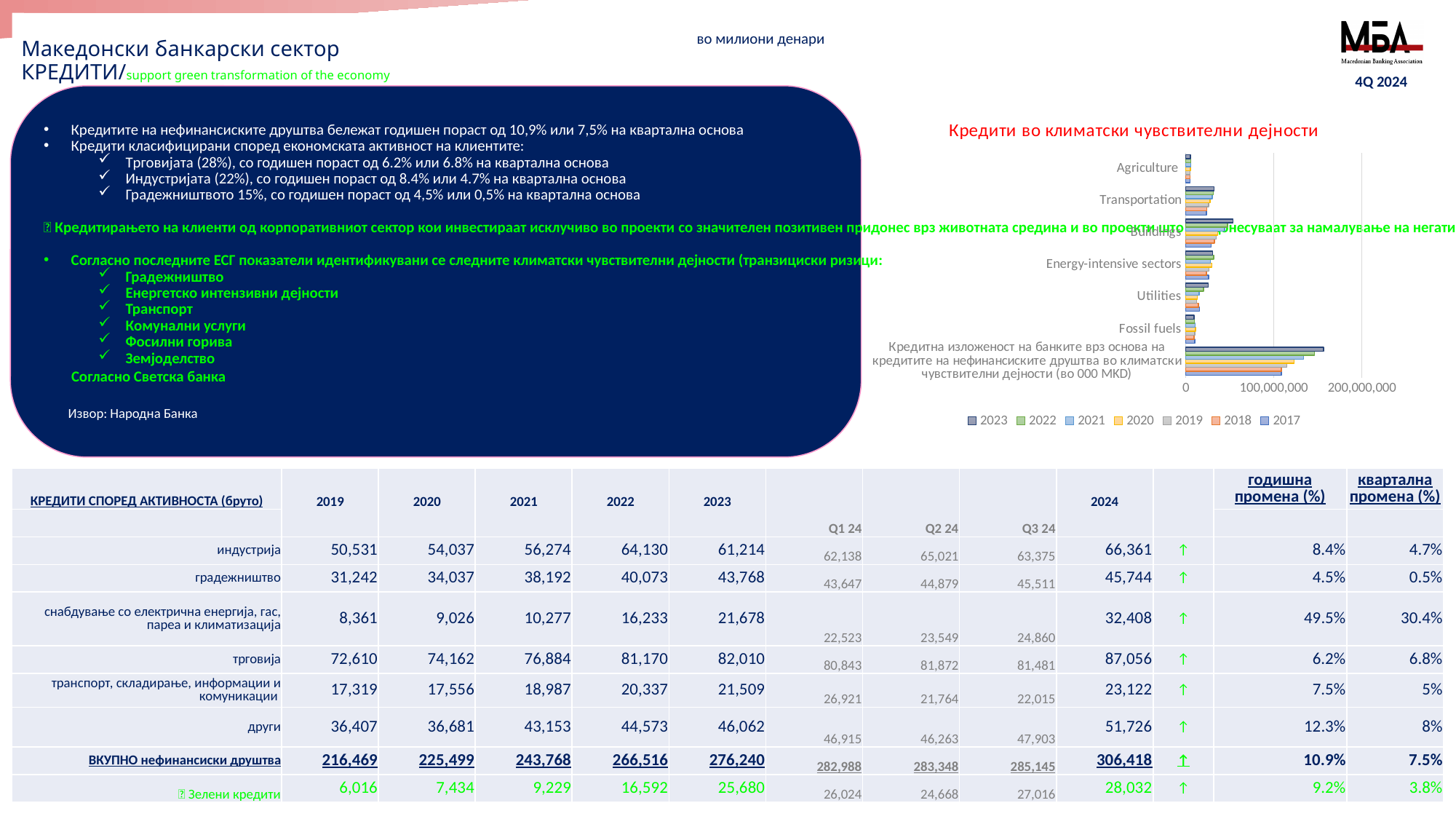
In the chart "Кредити во климатски чувствителни дејности", which category has the longest bars? Кредитна изложеност на банките врз основа на кредитите на нефинансиските друштва во климатски чувствителни дејности (во 000 MKD) In the chart "Кредити во климатски чувствителни дејности", is the 2023 value for the total credit exposure category greater or less than 100,000,000? greater In the chart "Кредити во климатски чувствителни дејности", is the 2023 value for Buildings greater or less than 100,000,000? less How many series does the legend of the chart "Кредити во климатски чувствителни дејности" list? 7 Which years are listed in the legend of the chart "Кредити во климатски чувствителни дејности"? 2023, 2022, 2021, 2020, 2019, 2018, 2017 What is the highest tick value shown on the horizontal axis of the chart "Кредити во климатски чувствителни дејности"? 200,000,000 In the chart "Кредити во климатски чувствителни дејности", which has the larger 2023 value: Buildings or Agriculture? Buildings In the chart "Кредити во климатски чувствителни дејности", which named sector has the shortest bars? Agriculture What kind of chart is shown under the title "Кредити во климатски чувствителни дејности"? bar chart In the chart "Кредити во климатски чувствителни дејности", is the 2023 value for Agriculture greater or less than 100,000,000? less In the chart "Кредити во климатски чувствителни дејности", which has the larger 2023 value: Transportation or Fossil fuels? Transportation How many categories are shown on the vertical axis of the chart "Кредити во климатски чувствителни дејности"? 7